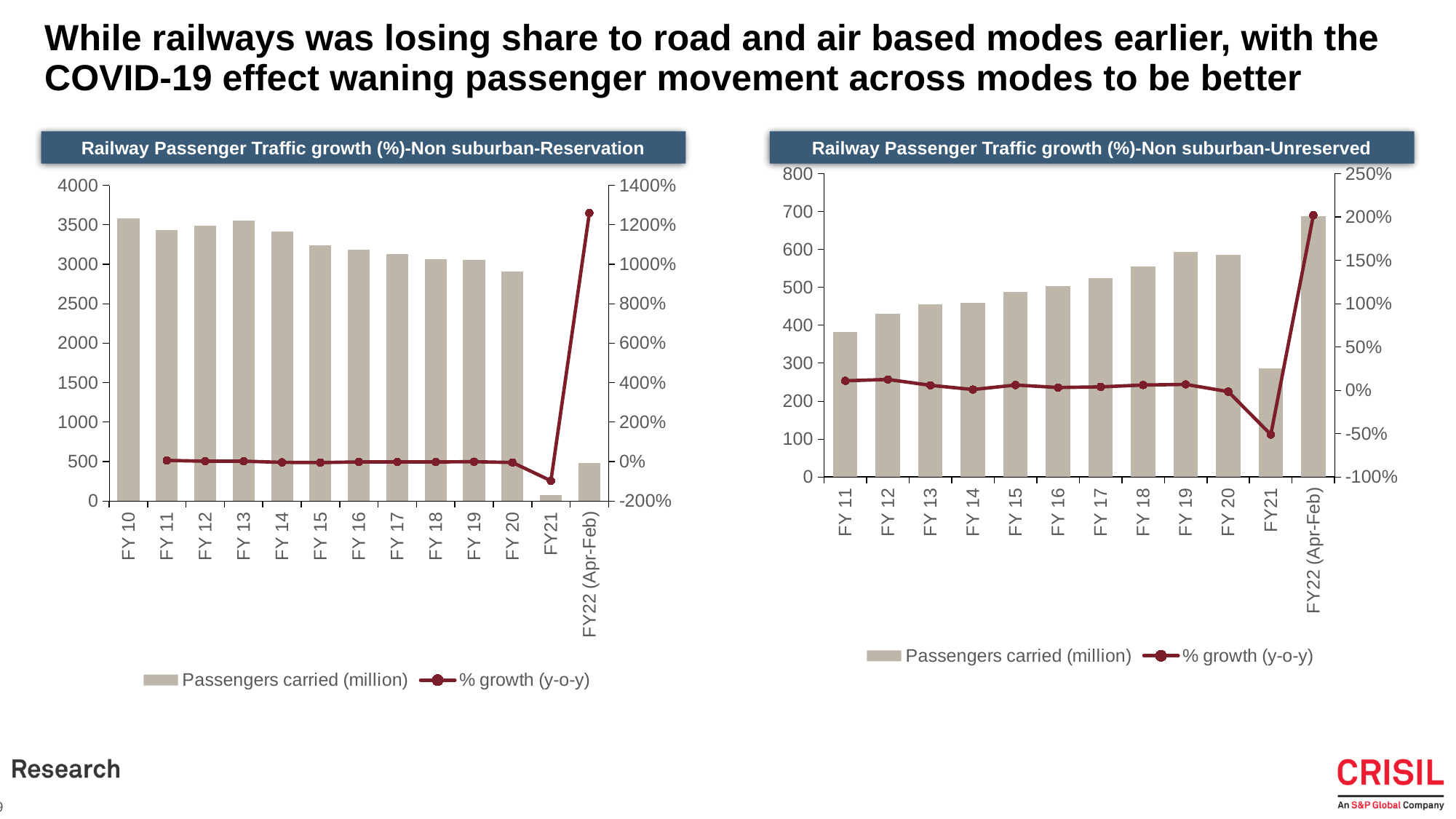
On the Railway Passenger Traffic growth (%)-Non suburban-Unreserved chart, how many fiscal-year categories are shown on the x axis? 12 On the Railway Passenger Traffic growth (%)-Non suburban-Reservation chart, which year has more passengers carried, FY 12 or FY 15? FY 12 On the Railway Passenger Traffic growth (%)-Non suburban-Unreserved chart, is the passengers carried value for FY 19 greater or less than 500? greater On the Railway Passenger Traffic growth (%)-Non suburban-Reservation chart, which year has the lowest number of passengers carried? FY21 On the Railway Passenger Traffic growth (%)-Non suburban-Reservation chart, is the passengers carried value for FY 20 greater or less than 3000? less On the Railway Passenger Traffic growth (%)-Non suburban-Unreserved chart, is the % growth (y-o-y) for FY22 (Apr-Feb) greater or less than 150%? greater On the Railway Passenger Traffic growth (%)-Non suburban-Unreserved chart, which year has the lowest number of passengers carried? FY21 On the Railway Passenger Traffic growth (%)-Non suburban-Unreserved chart, which year has the highest number of passengers carried? FY22 (Apr-Feb) On the Railway Passenger Traffic growth (%)-Non suburban-Unreserved chart, do the passengers carried values rise or fall from FY 11 to FY 19? rise On the Railway Passenger Traffic growth (%)-Non suburban-Reservation chart, how many series does the legend list? 2 On the Railway Passenger Traffic growth (%)-Non suburban-Reservation chart, how many fiscal-year categories are shown on the x axis? 13 On the Railway Passenger Traffic growth (%)-Non suburban-Reservation chart, which year has the highest number of passengers carried? FY 10